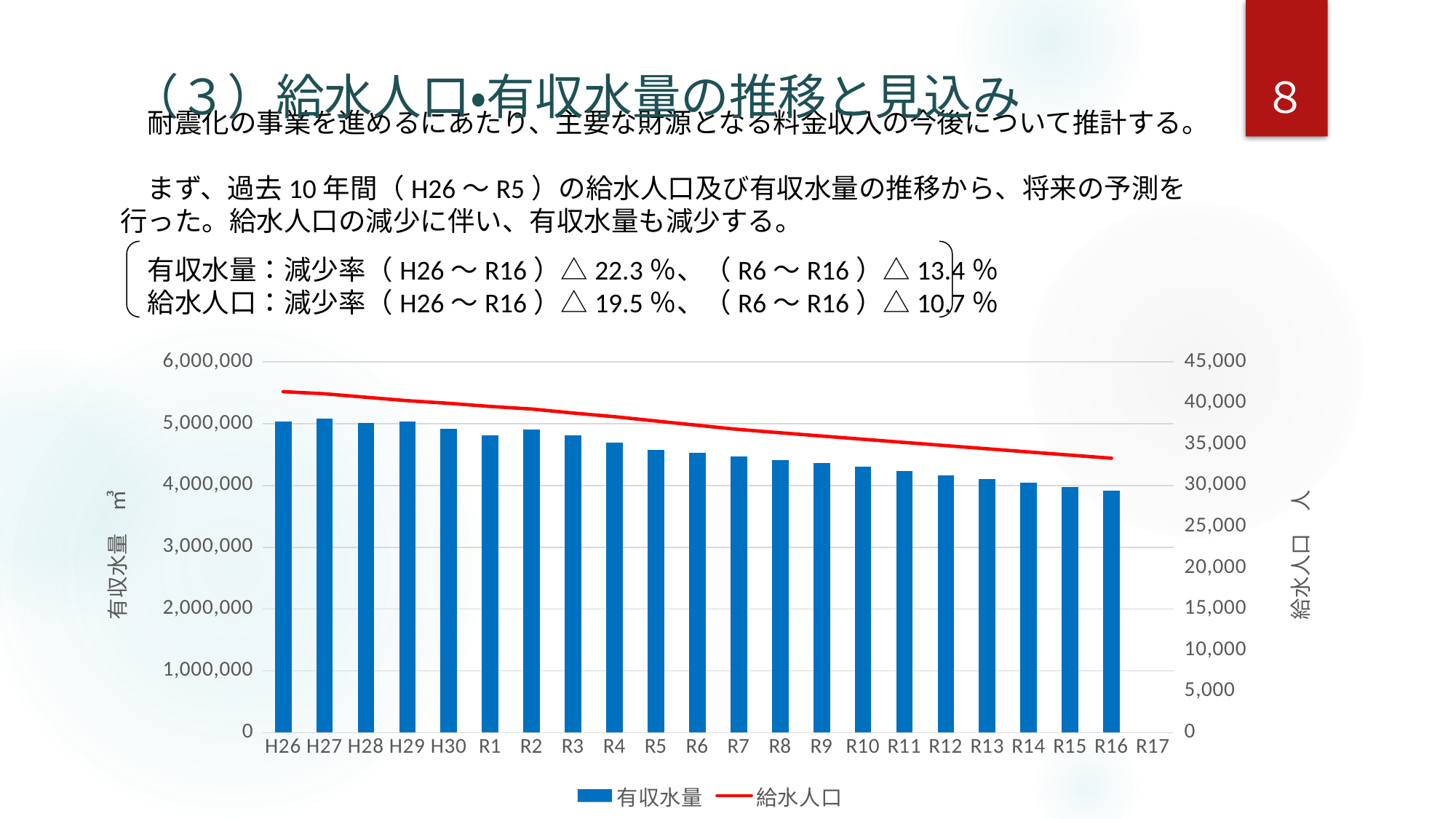
Which year has the lowest 有収水量 bar? R16 Do the 有収水量 bars generally rise or fall from H26 to R16? Fall Is the 有収水量 bar for R10 greater or less than 4,000,000? greater Is the 有収水量 bar for R16 greater or less than 4,000,000? less How many series does the chart legend list? 2 What are the two series named in the chart legend? 有収水量 and 給水人口 What kind of chart is shown on the slide? A bar chart combined with a line Which is larger, the 有収水量 bar for H26 or for R16? H26 Which series is drawn as a red line in the chart? 給水人口 How many bars (有収水量 values) are plotted in the chart? 21 Is the 給水人口 value for R16 greater or less than 35,000? less Does the 給水人口 line rise or fall from H26 to R16? Fall